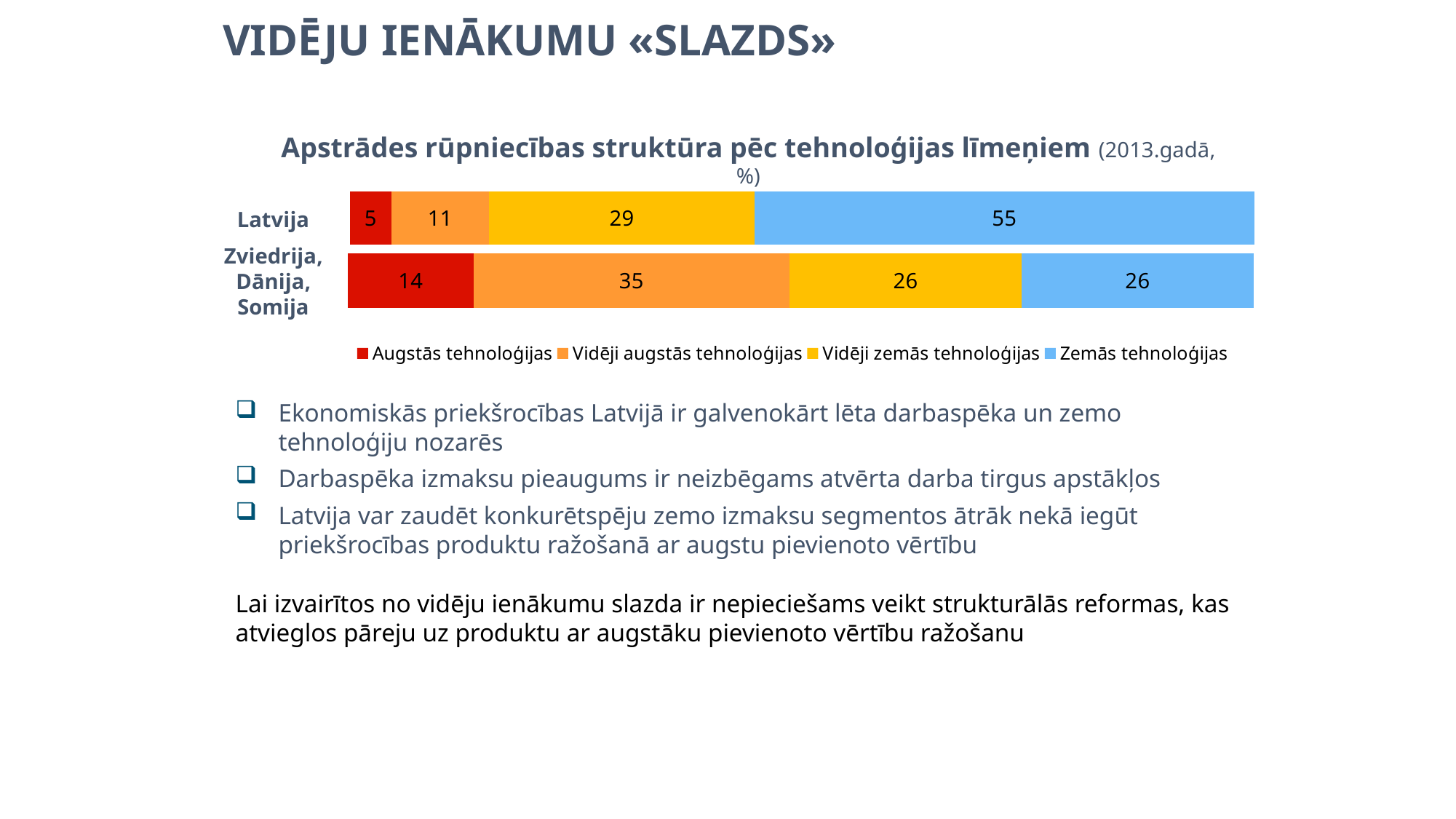
What is the value for Zemās tehnoloģijas for Latvija? 55 What is the value for Augstās tehnoloģijas for Zviedrija, Dānija, Somija? 14 What is the value for Vidēji augstās tehnoloģijas for Latvija? 11 What is the value for Vidēji zemās tehnoloģijas for Zviedrija, Dānija, Somija? 26 How many series does the legend list? 4 What is the difference between the Vidēji augstās tehnoloģijas values for Zviedrija, Dānija, Somija and Latvija? 24 What is the total of the stacked bar for Zviedrija, Dānija, Somija? 101 Which category has the higher value for Augstās tehnoloģijas, Latvija or Zviedrija, Dānija, Somija? Zviedrija, Dānija, Somija What is the difference between the Zemās tehnoloģijas values for Latvija and Zviedrija, Dānija, Somija? 29 What kind of chart is shown on the slide? Stacked bar chart How many categories are shown on the chart? 2 What is the total of the stacked bar for Latvija? 100